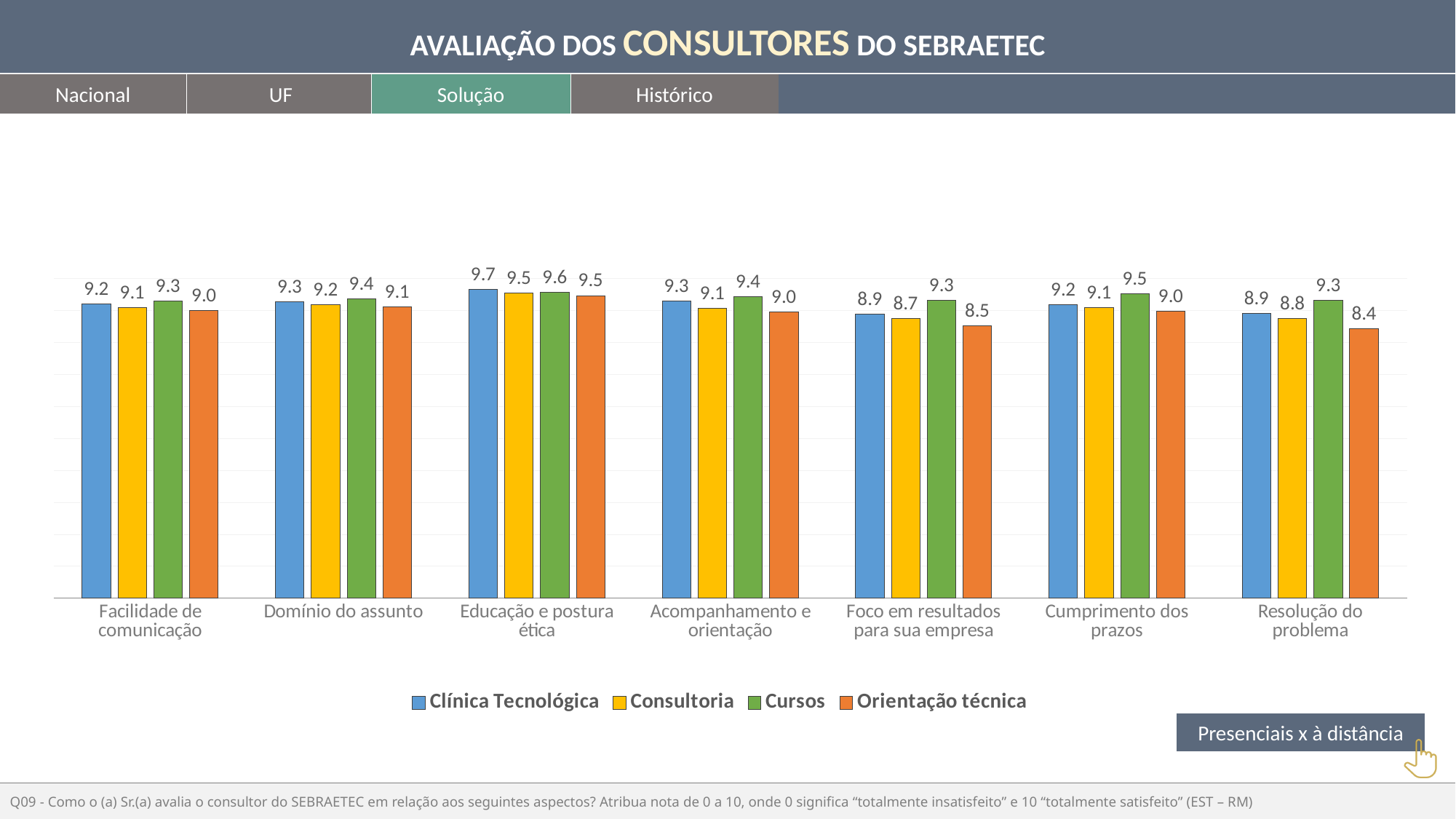
Which category has the highest value for Clínica Tecnológica? Educação e postura ética Which category has the lowest value for Orientação técnica? Resolução do problema What is the value for Consultoria in the Cumprimento dos prazos category? 9.1 What is the value for Cursos in the Educação e postura ética category? 9.6 What is the value for Orientação técnica in the Resolução do problema category? 8.4 Which is larger in the Domínio do assunto category: Clínica Tecnológica or Consultoria? Clínica Tecnológica How many series does the legend list? 4 What kind of chart is shown on the slide? Bar chart What is the value for Clínica Tecnológica in the Foco em resultados para sua empresa category? 8.9 Which series is shown in orange in the legend? Orientação técnica What is the difference between the Cursos and Orientação técnica values in the Foco em resultados para sua empresa category? 0.8 How many categories are shown on the x axis? 7